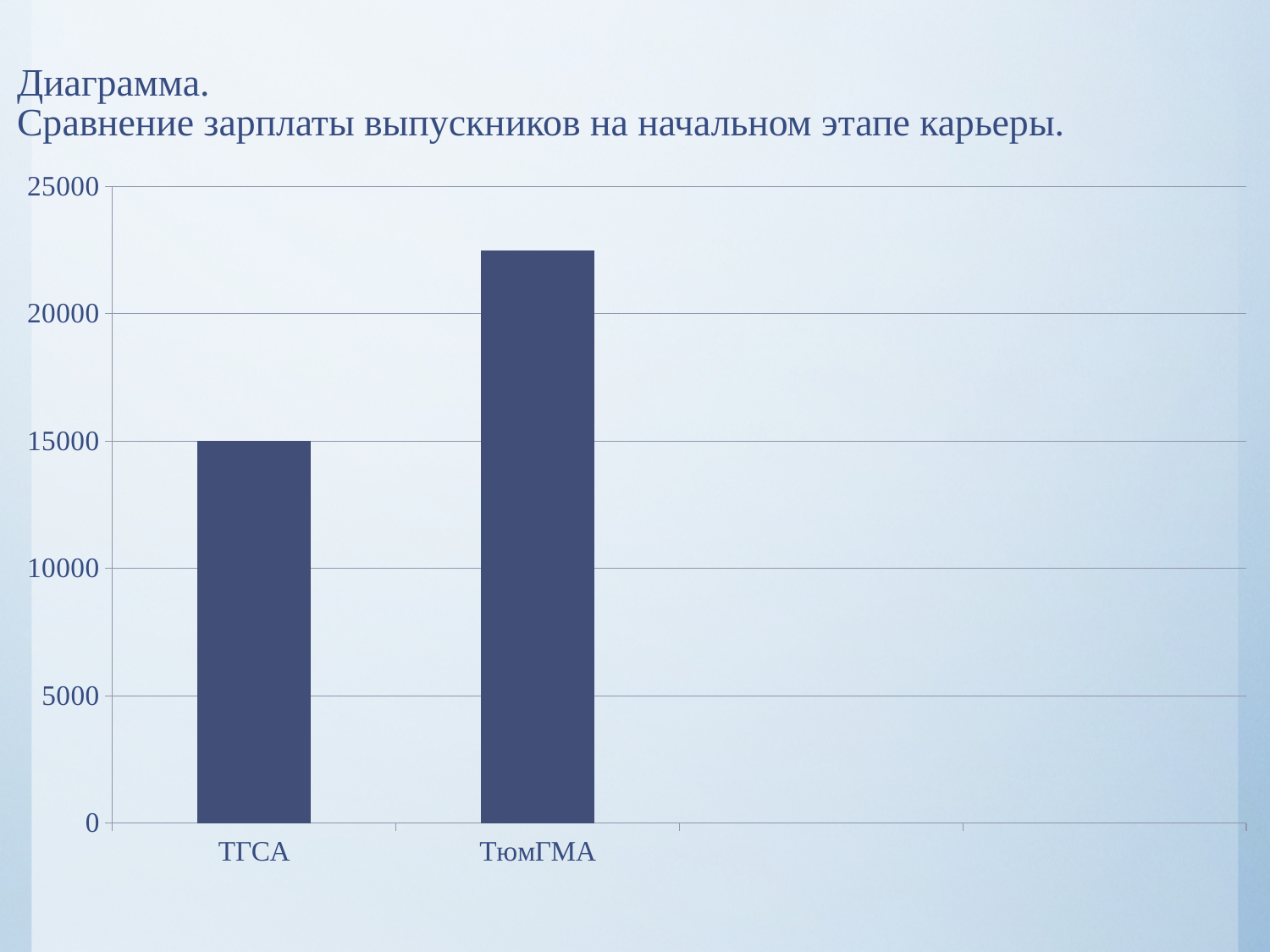
Do the values rise or fall from left to right along the x axis? rise Is the value for ТГСА greater or less than 20000? less Is the value for ТюмГМА greater or less than 20000? greater What is the value for ТГСА? 15000 Which category has the highest value? ТюмГМА Which is larger, the value for ТГСА or the value for ТюмГМА? ТюмГМА How many categories are plotted in the chart? 2 Is the value for ТюмГМА greater or less than 25000? less What is the title of the chart on the slide? Сравнение зарплаты выпускников на начальном этапе карьеры. What is the highest value shown on the vertical axis? 25000 What kind of chart is shown on the slide? bar chart Which category has the lowest value? ТГСА